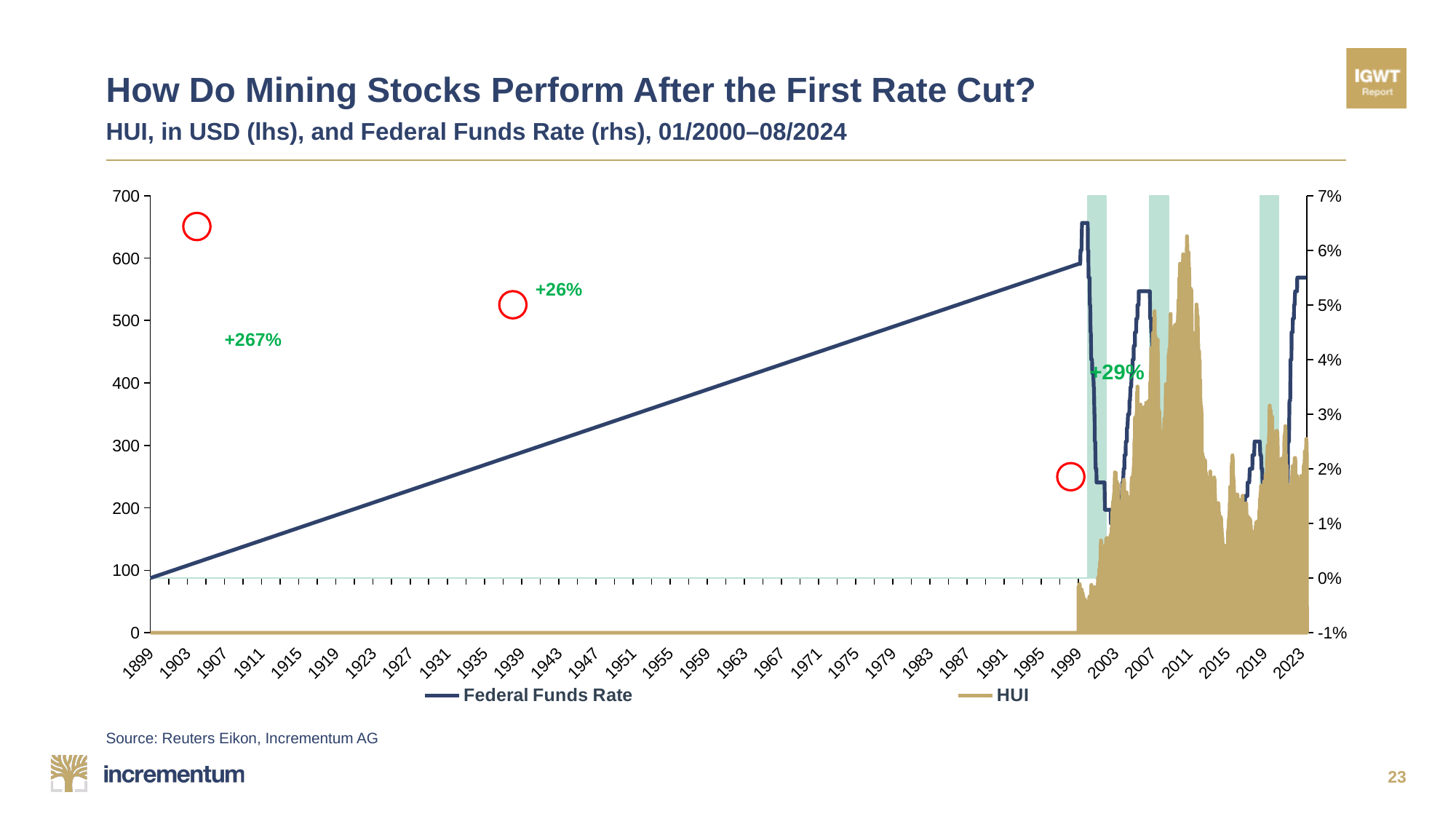
What percentage gain is annotated in green near the left side of the chart, below the first red circle? +267% What is the lowest value shown on the right-hand axis? -1% How many series does the legend list? 2 Is the Federal Funds Rate around 2013 greater or less than 1%? less What is the highest value shown on the left-hand axis? 700 What percentage gain is annotated in green inside the first shaded region around 2001–2003? +29% What is the title of the chart on the slide? How Do Mining Stocks Perform After the First Rate Cut? What percentage gain is annotated in green next to the red circle near 1939? +26% Is the peak value of HUI around 2011 greater or less than 600? greater Is the Federal Funds Rate in 2023 greater or less than 5%? greater What kind of chart is shown on the slide? Line chart with an area series